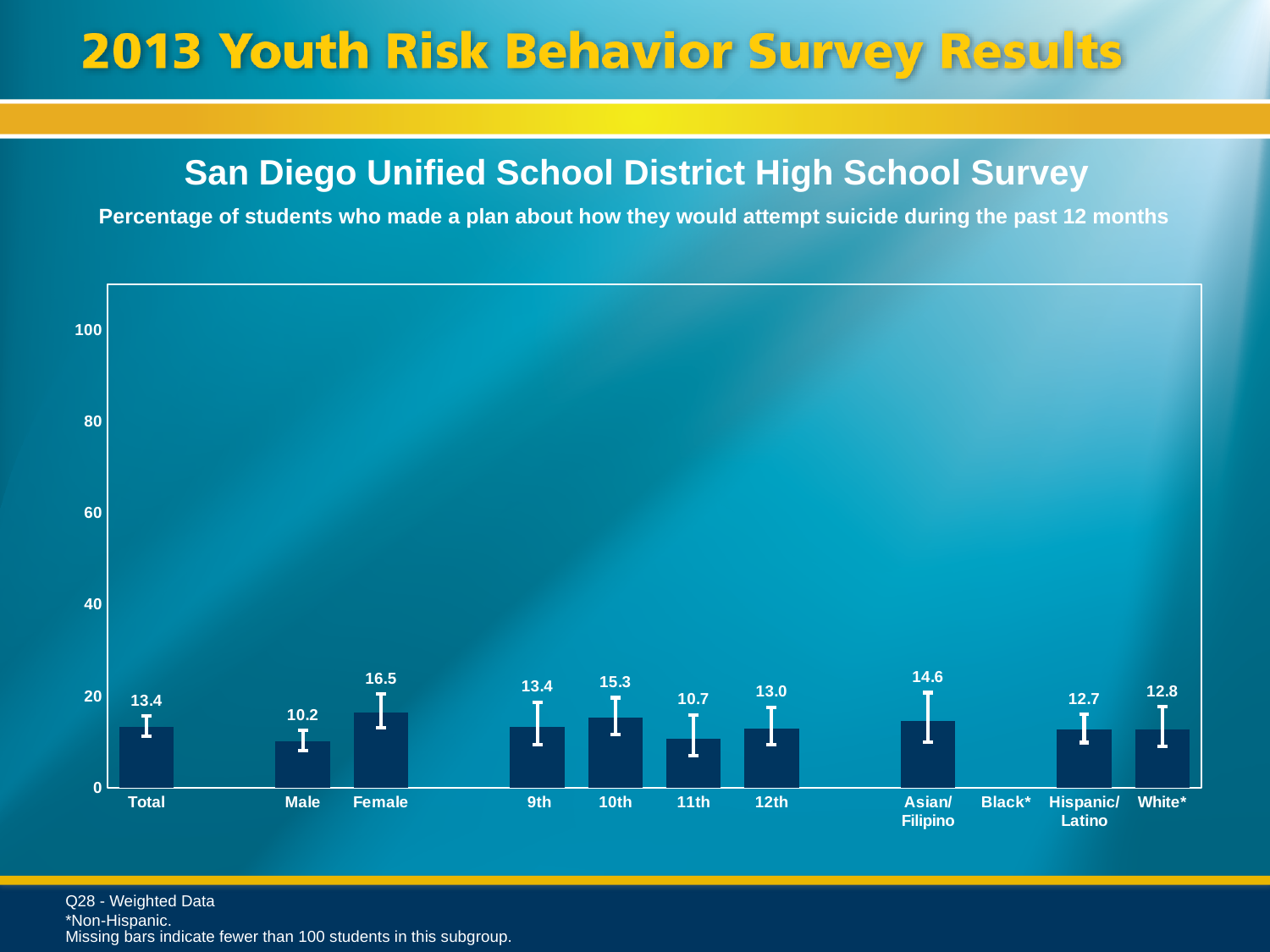
Which category has the lowest value among those with bars? Male What kind of chart is this? bar chart What is the value for Hispanic/Latino? 12.7 What is the value for Female? 16.5 What is the difference between the Female and Male values? 6.3 Which category has the highest value? Female Is the value for Total greater or less than 20? less What is the value for Asian/Filipino? 14.6 What is the value for 11th grade? 10.7 Which is larger, the value for 10th grade or 12th grade? 10th Which category has no bar shown? Black* What is the value for Male? 10.2